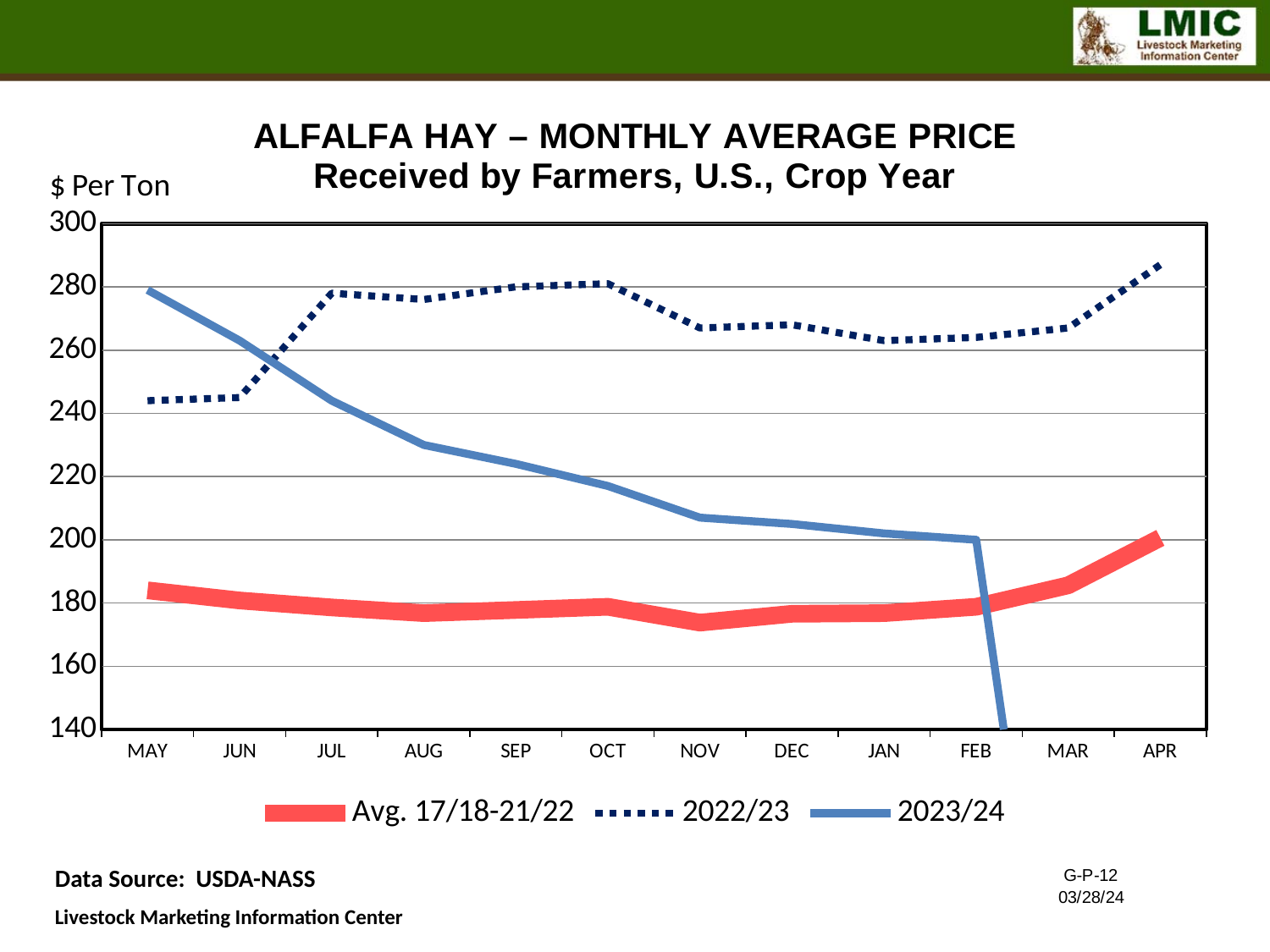
How many series does the legend list? 3 In which month is the 2022/23 series at its highest? APR How many months are shown along the x axis? 12 In MAY, which series has the higher value, 2022/23 or 2023/24? 2023/24 Does the 2023/24 line rise or fall from MAY to FEB? fall What kind of chart is shown on the slide? line chart Is the value for Avg. 17/18-21/22 in NOV greater or less than 180? less In JUL, which series has the higher value, 2022/23 or 2023/24? 2022/23 Is the value for 2023/24 in DEC greater or less than 220? less Is the value for 2022/23 in MAY greater or less than 260? less